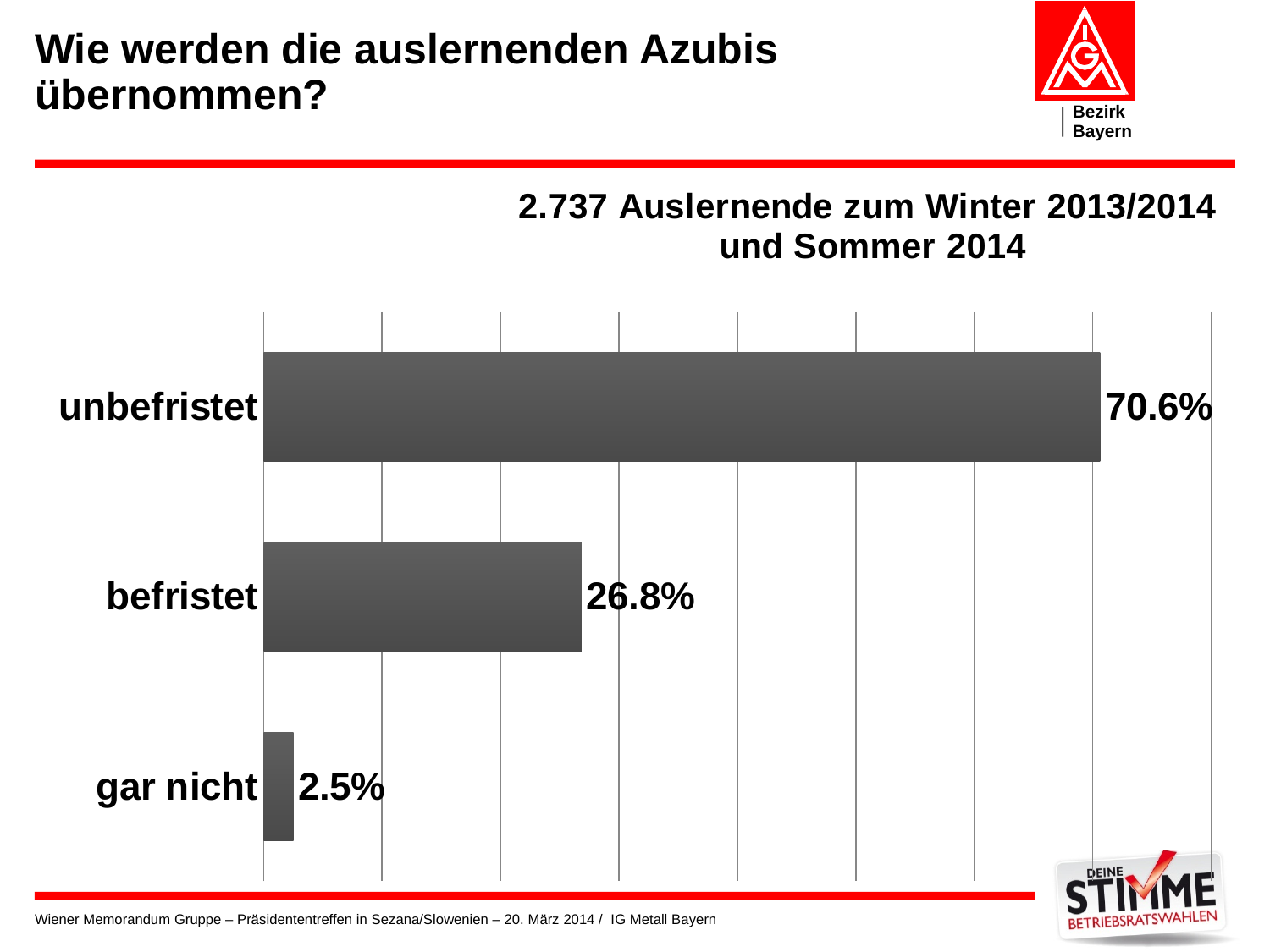
How many Auslernende does the chart heading say the data covers? 2.737 What is the value for "befristet"? 26.8% What is the difference between the values for "unbefristet" and "befristet"? 43.8% What kind of chart is shown on the slide? bar chart Which category has the lowest value? gar nicht Which is larger, the value for "befristet" or the value for "gar nicht"? befristet Which category has the highest value? unbefristet What is the value for "gar nicht"? 2.5% What is the difference between the values for "befristet" and "gar nicht"? 24.3% What is the value for "unbefristet"? 70.6% What is the total of the three values shown in the chart? 99.9% How many categories are shown in the chart? 3